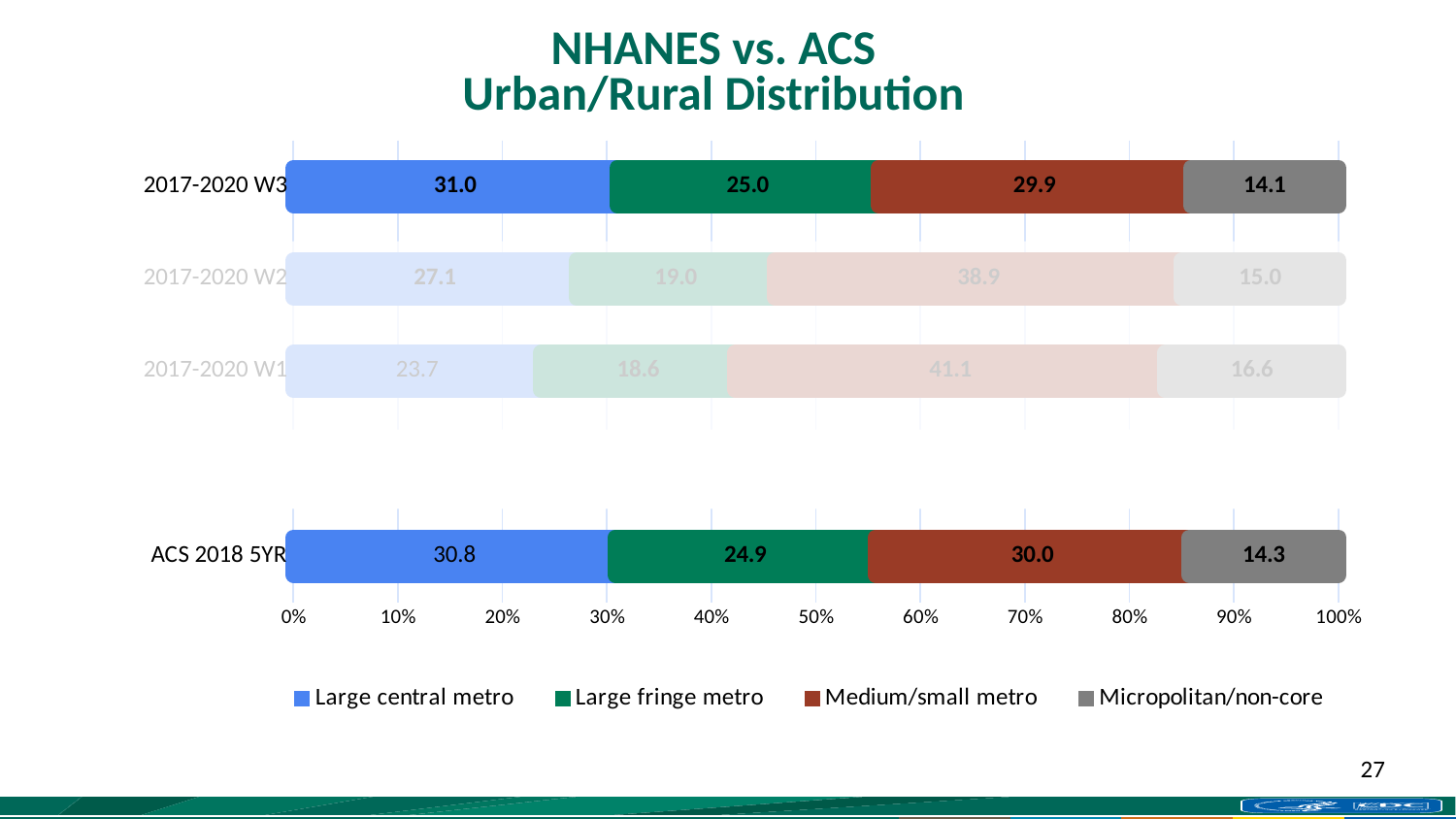
What is the value for Micropolitan/non-core in the 2017-2020 W1 bar? 16.6 What is the difference between the Medium/small metro values for 2017-2020 W1 and 2017-2020 W3? 11.2 How many series does the legend list? 4 What is the title of the chart? NHANES vs. ACS Urban/Rural Distribution What is the value for Large central metro in the 2017-2020 W3 bar? 31.0 Which bar has the highest value for Medium/small metro? 2017-2020 W1 What kind of chart is shown on the slide? Stacked bar chart How many bars (categories) are shown in the chart? 4 What is the value for Large fringe metro in the 2017-2020 W2 bar? 19.0 What is the value for Medium/small metro in the ACS 2018 5YR bar? 30.0 Which is larger: the Large central metro value for 2017-2020 W2 or for 2017-2020 W1? 2017-2020 W2 Which bar has the lowest value for Large central metro? 2017-2020 W1